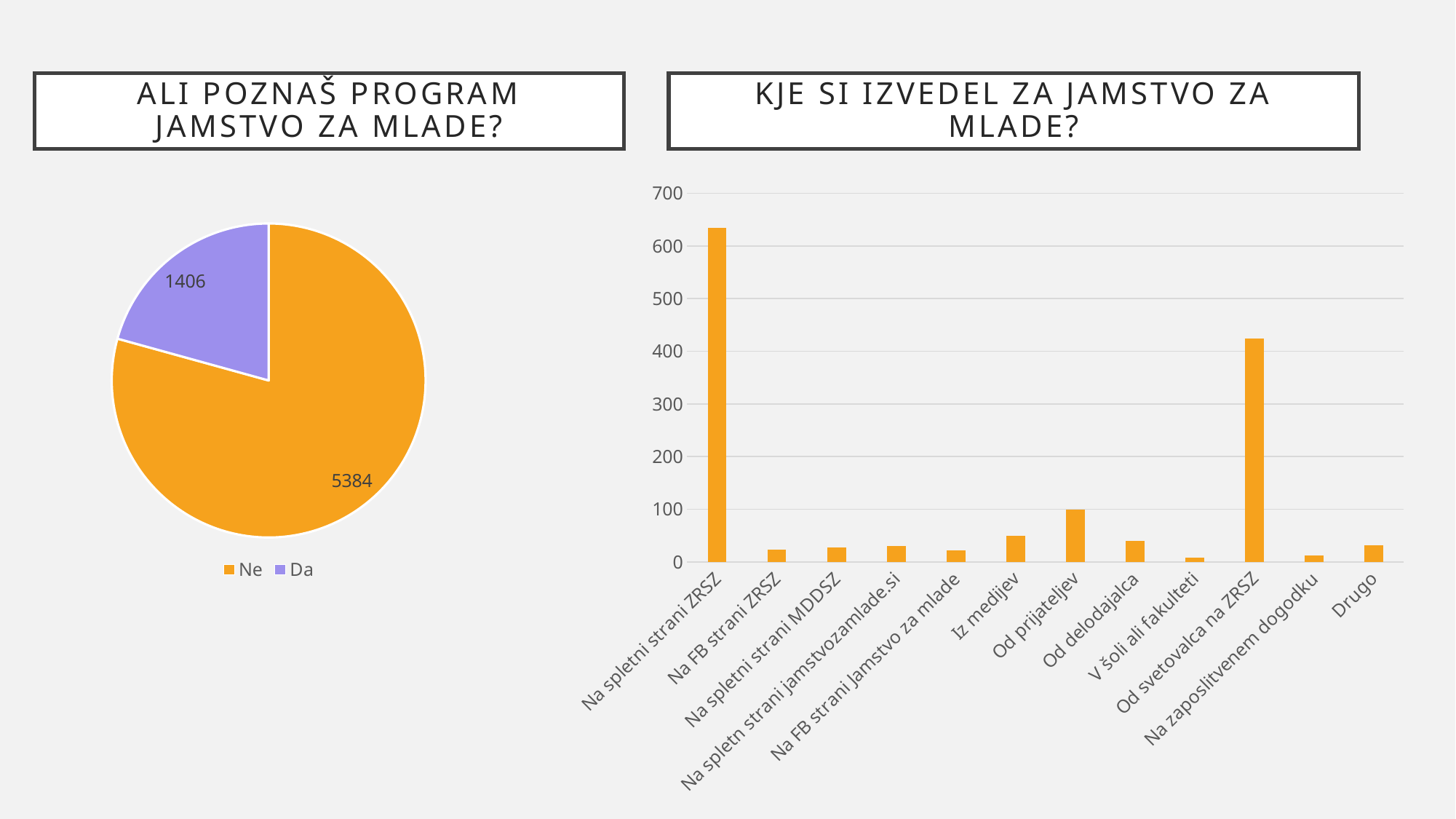
In the pie chart 'ALI POZNAŠ PROGRAM JAMSTVO ZA MLADE?', which slice is larger, 'Ne' or 'Da'? Ne In the bar chart 'KJE SI IZVEDEL ZA JAMSTVO ZA MLADE?', is the value for 'Na spletni strani ZRSZ' greater or less than 600? greater In the bar chart 'KJE SI IZVEDEL ZA JAMSTVO ZA MLADE?', which is larger, 'Od svetovalca na ZRSZ' or 'Od prijateljev'? Od svetovalca na ZRSZ In the pie chart 'ALI POZNAŠ PROGRAM JAMSTVO ZA MLADE?', how many entries does the legend list? 2 In the pie chart 'ALI POZNAŠ PROGRAM JAMSTVO ZA MLADE?', what is the value for 'Ne'? 5384 What type of chart is 'KJE SI IZVEDEL ZA JAMSTVO ZA MLADE?'? Bar chart In the pie chart 'ALI POZNAŠ PROGRAM JAMSTVO ZA MLADE?', what is the difference between the 'Ne' and 'Da' values? 3978 In the bar chart 'KJE SI IZVEDEL ZA JAMSTVO ZA MLADE?', which category has the highest value? Na spletni strani ZRSZ In the bar chart 'KJE SI IZVEDEL ZA JAMSTVO ZA MLADE?', is the value for 'Od svetovalca na ZRSZ' greater or less than 400? greater In the bar chart 'KJE SI IZVEDEL ZA JAMSTVO ZA MLADE?', how many categories are shown on the x axis? 12 In the pie chart 'ALI POZNAŠ PROGRAM JAMSTVO ZA MLADE?', what is the value for 'Da'? 1406 In the pie chart 'ALI POZNAŠ PROGRAM JAMSTVO ZA MLADE?', what is the total of the two slices? 6790